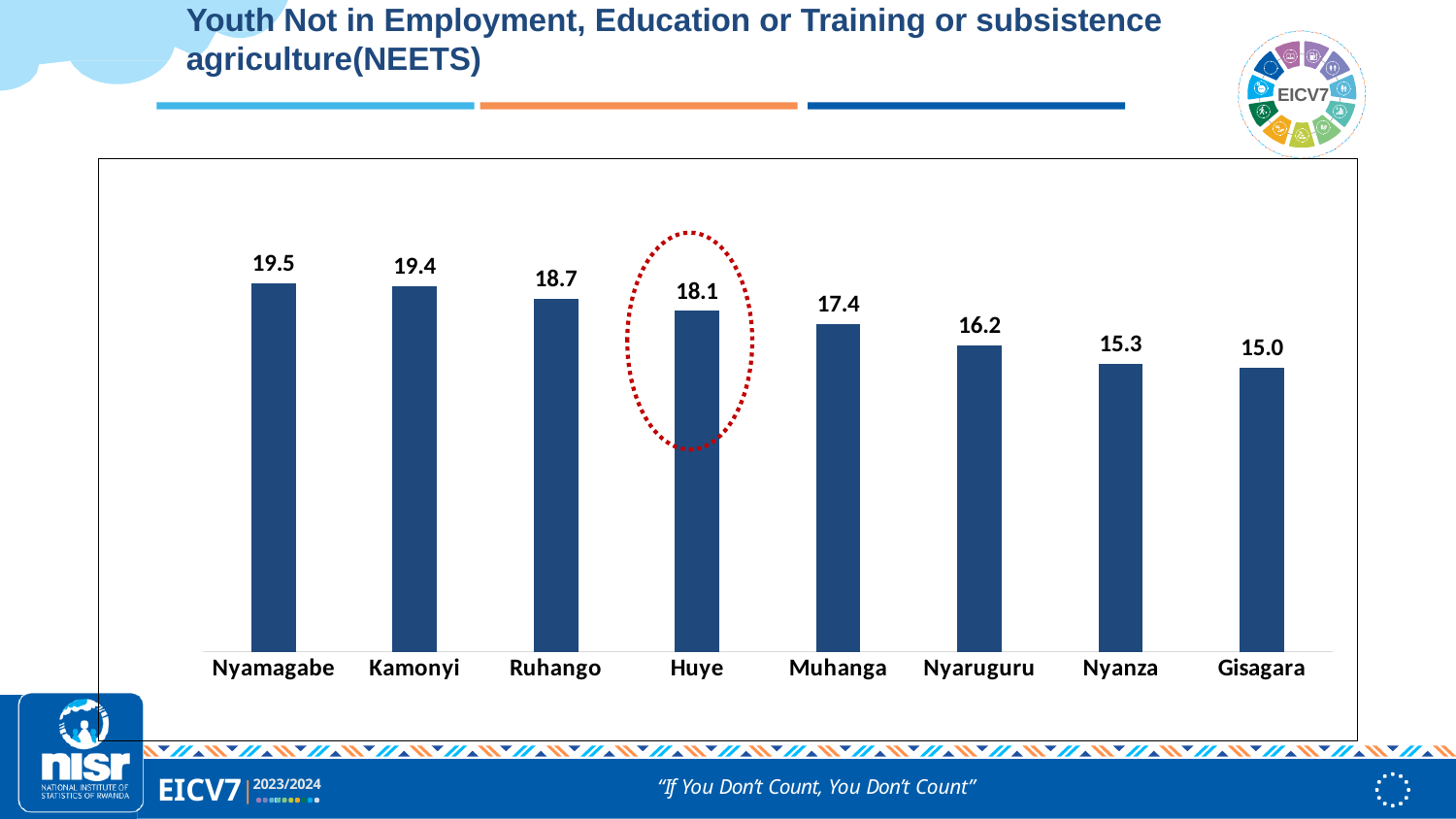
Which district has the lowest value? Gisagara What is the value for Nyaruguru? 16.2 Which district's bar is highlighted with a red dotted circle? Huye What is the value for Gisagara? 15.0 What is the value for Huye? 18.1 Which district has the highest value? Nyamagabe How many districts are shown in the chart? 8 What kind of chart is shown on the slide? Bar chart What is the difference between the values for Nyamagabe and Gisagara? 4.5 Which is larger, the value for Muhanga or the value for Nyanza? Muhanga What is the difference between the values for Ruhango and Huye? 0.6 Do the values rise or fall from left to right across the districts? Fall